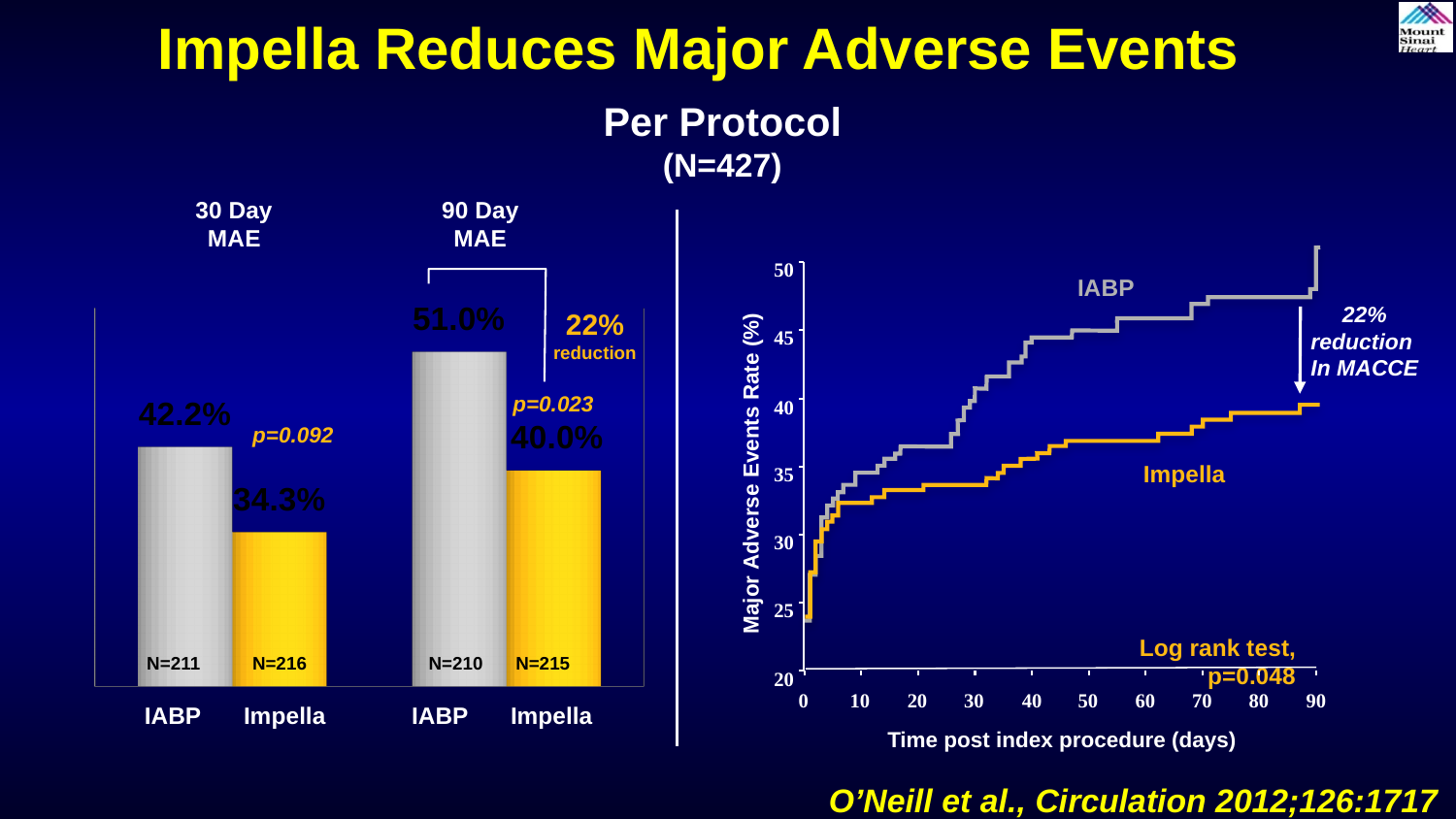
In the bar chart on the left, what is the p-value shown for the 90 Day MAE comparison? p=0.023 In the bar chart on the left, what is the 90 Day MAE value for IABP? 51.0% In the bar chart on the left, what is the 30 Day MAE value for IABP? 42.2% In the bar chart on the left, which bar is the lowest? 30 Day MAE Impella In the bar chart on the left, what is the difference between the 30 Day MAE values for IABP and Impella? 7.9% In the bar chart on the left, what is the difference between the 90 Day MAE values for IABP and Impella? 11.0% In the bar chart on the left, what is the N for the 30 Day Impella group? N=216 In the bar chart on the left, which bar is the highest? 90 Day MAE IABP What kind of chart is on the left side of the slide? Bar chart In the line chart on the right, is the Impella value at 90 days greater or less than 45? less In the line chart on the right, is the IABP value at 90 days greater or less than 45? greater In the bar chart on the left, what is the 90 Day MAE value for Impella? 40.0%